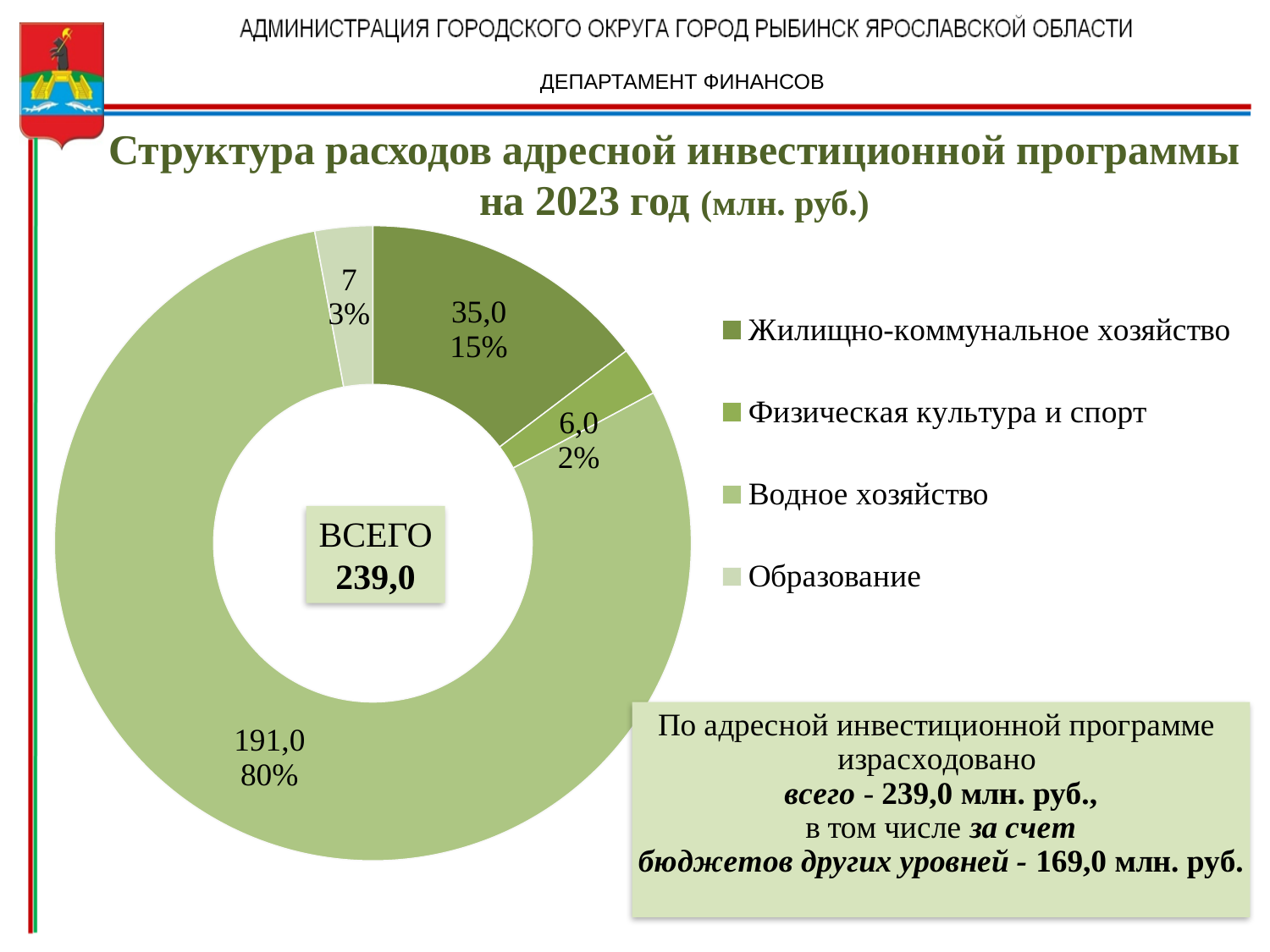
What is the value for Водное хозяйство? 191,0 What kind of chart is shown on the slide? Doughnut (pie) chart Which category has the largest value? Водное хозяйство What share of the chart does Водное хозяйство take? 80% Which category has the smallest value? Физическая культура и спорт What is the difference between the values for Водное хозяйство and Жилищно-коммунальное хозяйство? 156,0 How many categories does the legend list? 4 What is the value for Жилищно-коммунальное хозяйство? 35,0 What is the value for Образование? 7 What share of the chart does Жилищно-коммунальное хозяйство take? 15% Which is larger, the value for Образование or the value for Физическая культура и спорт? Образование What is the value for Физическая культура и спорт? 6,0